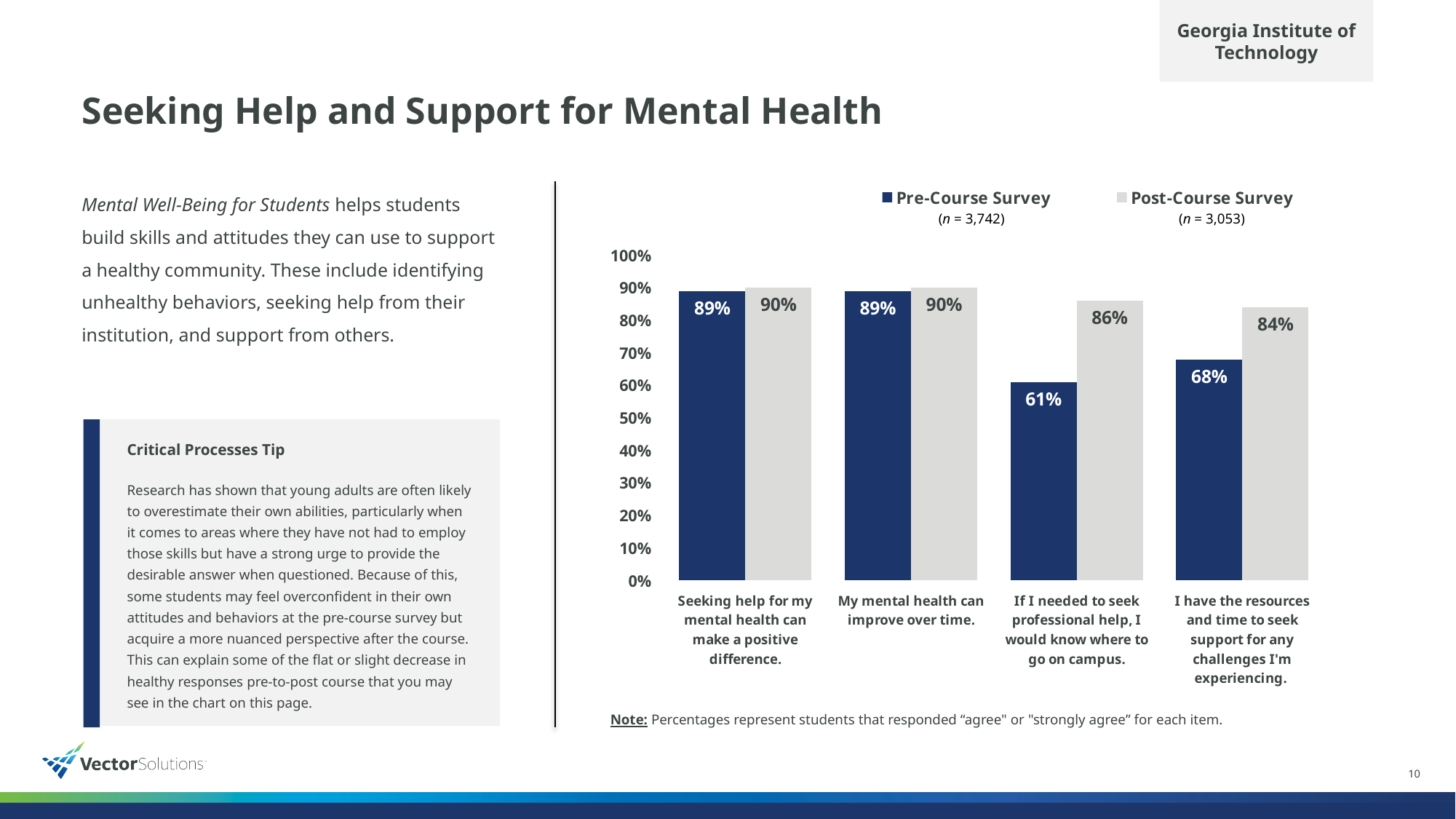
Which category has the lowest Post-Course Survey value? I have the resources and time to seek support for any challenges I'm experiencing. What is the Post-Course Survey value for "My mental health can improve over time."? 90% What is the difference between the Post-Course and Pre-Course Survey values for "If I needed to seek professional help, I would know where to go on campus."? 25% What is the Pre-Course Survey value for "If I needed to seek professional help, I would know where to go on campus."? 61% Which is larger for "Seeking help for my mental health can make a positive difference.": the Pre-Course Survey value or the Post-Course Survey value? Post-Course Survey How many categories are shown on the x axis of the chart? 4 What is the difference between the Post-Course and Pre-Course Survey values for "I have the resources and time to seek support for any challenges I'm experiencing."? 16% What is the sample size (n) for the Pre-Course Survey shown in the legend? 3,742 What is the Post-Course Survey value for "I have the resources and time to seek support for any challenges I'm experiencing."? 84% Which category has the lowest Pre-Course Survey value? If I needed to seek professional help, I would know where to go on campus. What kind of chart is shown on the slide? Bar chart How many series does the legend list? 2